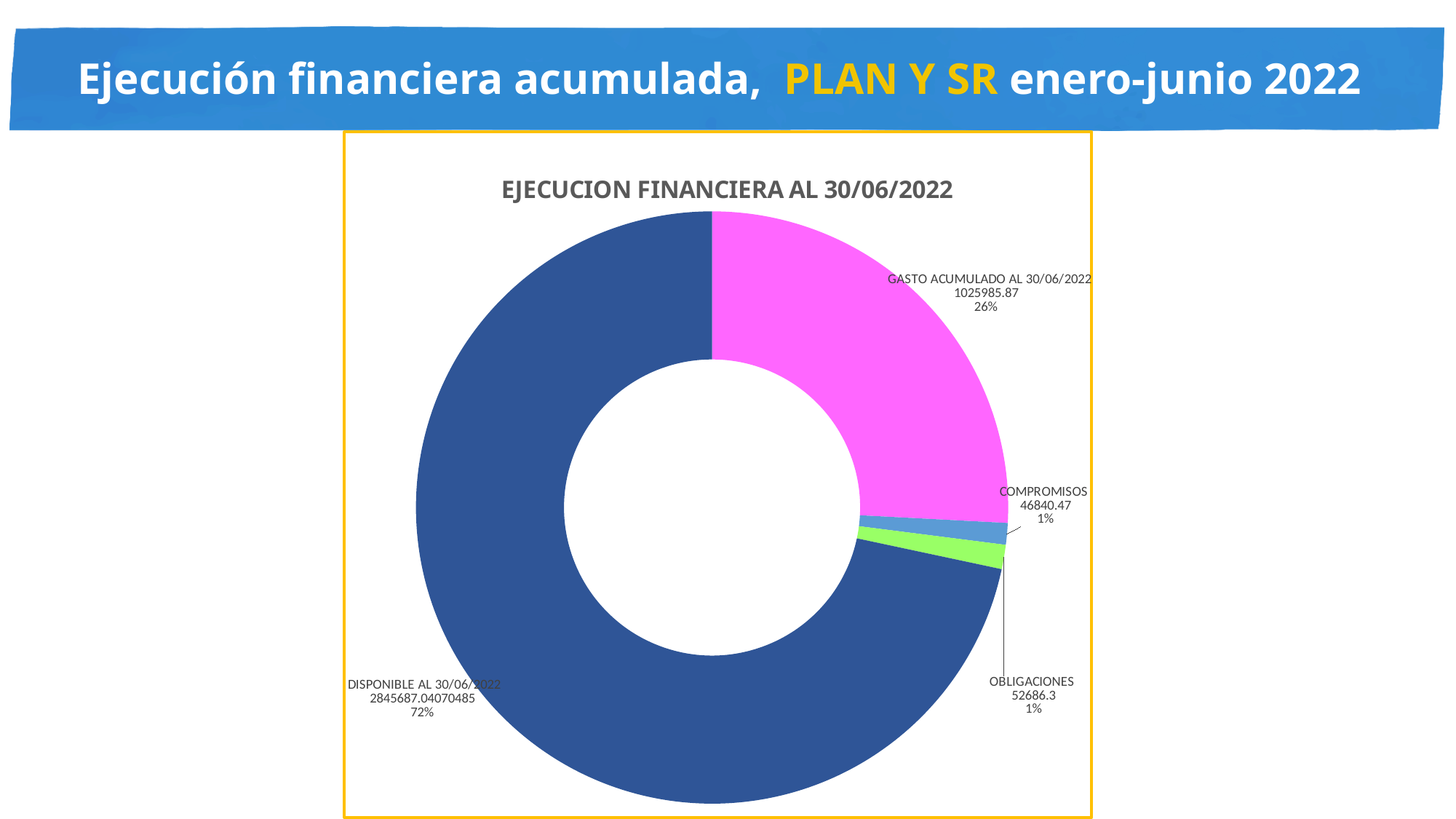
What kind of chart is shown on the slide? doughnut chart Which category has the largest slice? DISPONIBLE AL 30/06/2022 What is the value for COMPROMISOS? 46840.47 What is the title of the chart? EJECUCION FINANCIERA AL 30/06/2022 What is the value for GASTO ACUMULADO AL 30/06/2022? 1025985.87 What share of the chart does GASTO ACUMULADO AL 30/06/2022 represent? 26% What share of the chart does DISPONIBLE AL 30/06/2022 represent? 72% What is the value for DISPONIBLE AL 30/06/2022? 2845687.04070485 How many slices does the chart have? 4 What is the value for OBLIGACIONES? 52686.3 What is the difference between the values for OBLIGACIONES and COMPROMISOS? 5845.83 Which is larger, OBLIGACIONES or COMPROMISOS? OBLIGACIONES